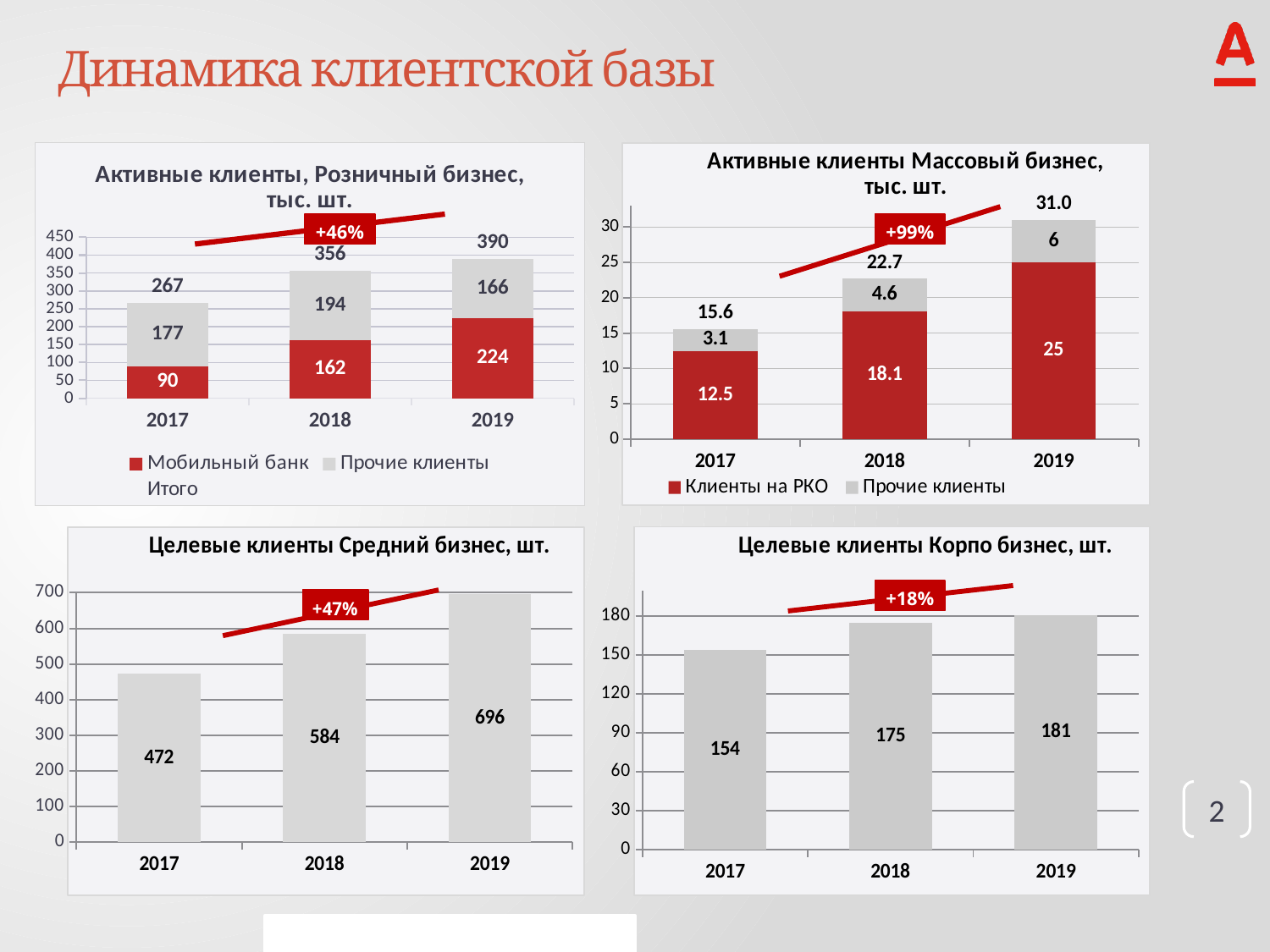
In the chart 'Целевые клиенты Средний бизнес, шт.', what is the difference between the 2019 and 2017 values? 224 In the chart 'Целевые клиенты Корпо бизнес, шт.', which year has the lowest value? 2017 In the chart 'Активные клиенты, Розничный бизнес, тыс. шт.', how many entries does the legend list? 3 In the chart 'Активные клиенты Массовый бизнес, тыс. шт.', which year has the highest total? 2019 In the chart 'Активные клиенты Массовый бизнес, тыс. шт.', what is the difference between the Прочие клиенты values for 2019 and 2017? 2.9 In the chart 'Целевые клиенты Корпо бизнес, шт.', how many bars are plotted? 3 In the chart 'Активные клиенты, Розничный бизнес, тыс. шт.', what is the total for 2018? 356 In the chart 'Целевые клиенты Средний бизнес, шт.', do the values rise or fall from 2017 to 2019? rise What kind of chart is 'Целевые клиенты Корпо бизнес, шт.'? bar chart In the chart 'Активные клиенты, Розничный бизнес, тыс. шт.', what is the value for Мобильный банк in 2019? 224 In the chart 'Целевые клиенты Средний бизнес, шт.', what is the value for 2018? 584 In the chart 'Активные клиенты Массовый бизнес, тыс. шт.', what is the value for Клиенты на РКО in 2018? 18.1